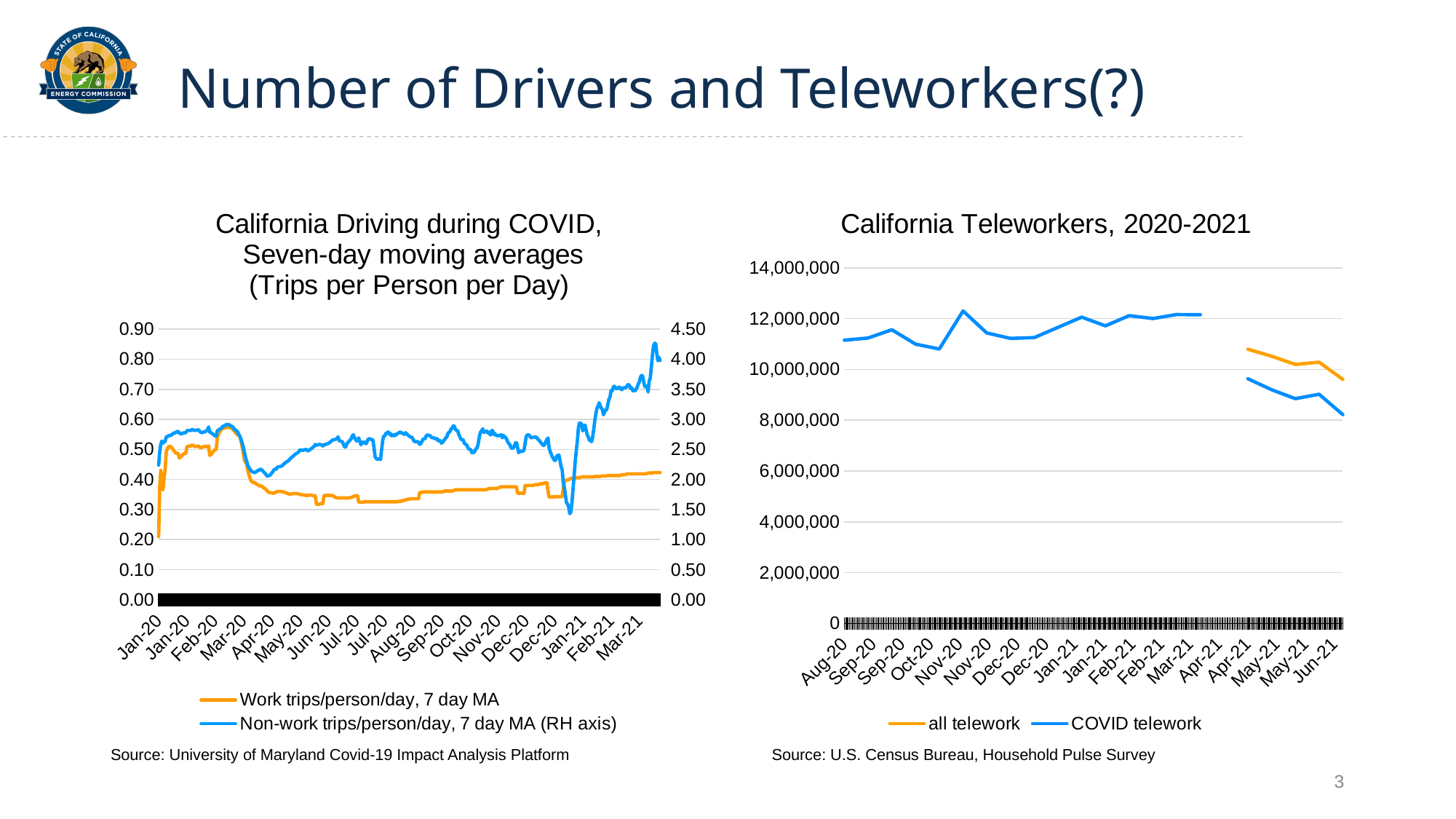
In the 'California Teleworkers, 2020-2021' chart, which series is higher in Apr-21, all telework or COVID telework? all telework In the 'California Teleworkers, 2020-2021' chart, does the COVID telework line rise or fall from Apr-21 to Jun-21? fall How many series does the legend of the 'California Teleworkers, 2020-2021' chart list? 2 How many series does the legend of the 'California Driving during COVID' chart list? 2 What type of chart is the 'California Teleworkers, 2020-2021' chart? line chart In the 'California Driving during COVID' chart, is the value for Work trips/person/day in Mar-21 greater or less than 0.50? less In the 'California Driving during COVID' chart, does the Non-work trips line rise or fall from Jan-21 to Mar-21? rise In the 'California Teleworkers, 2020-2021' chart, is the value for all telework in Jun-21 greater or less than 10,000,000? less In the 'California Teleworkers, 2020-2021' chart, is the value for COVID telework in Aug-20 greater or less than 10,000,000? greater What type of chart is the 'California Driving during COVID' chart? line chart Which series in the 'California Driving during COVID' chart is plotted on the right-hand axis? Non-work trips/person/day, 7 day MA